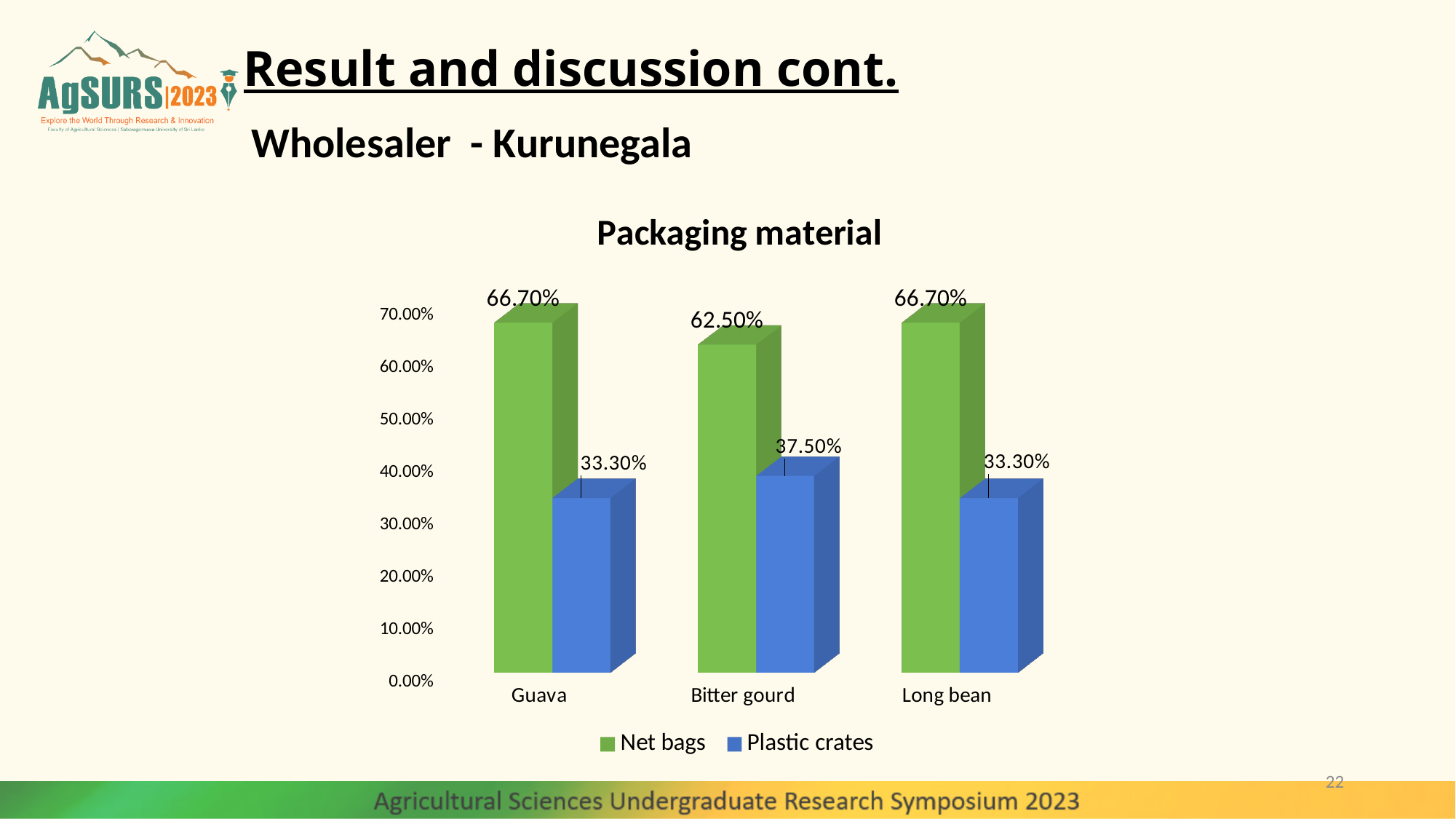
What kind of chart is shown? Bar chart What is the difference between the Net bags and Plastic crates values for Guava? 33.40% What is the Net bags value for Guava? 66.70% What is the title of the chart? Packaging material How many categories are shown on the x axis? 3 For Bitter gourd, which is larger: Net bags or Plastic crates? Net bags What is the Plastic crates value for Bitter gourd? 37.50% What is the Net bags value for Bitter gourd? 62.50% What is the Plastic crates value for Long bean? 33.30% Which category has the highest Plastic crates value? Bitter gourd Which category has the lowest Net bags value? Bitter gourd How many series does the legend list? 2